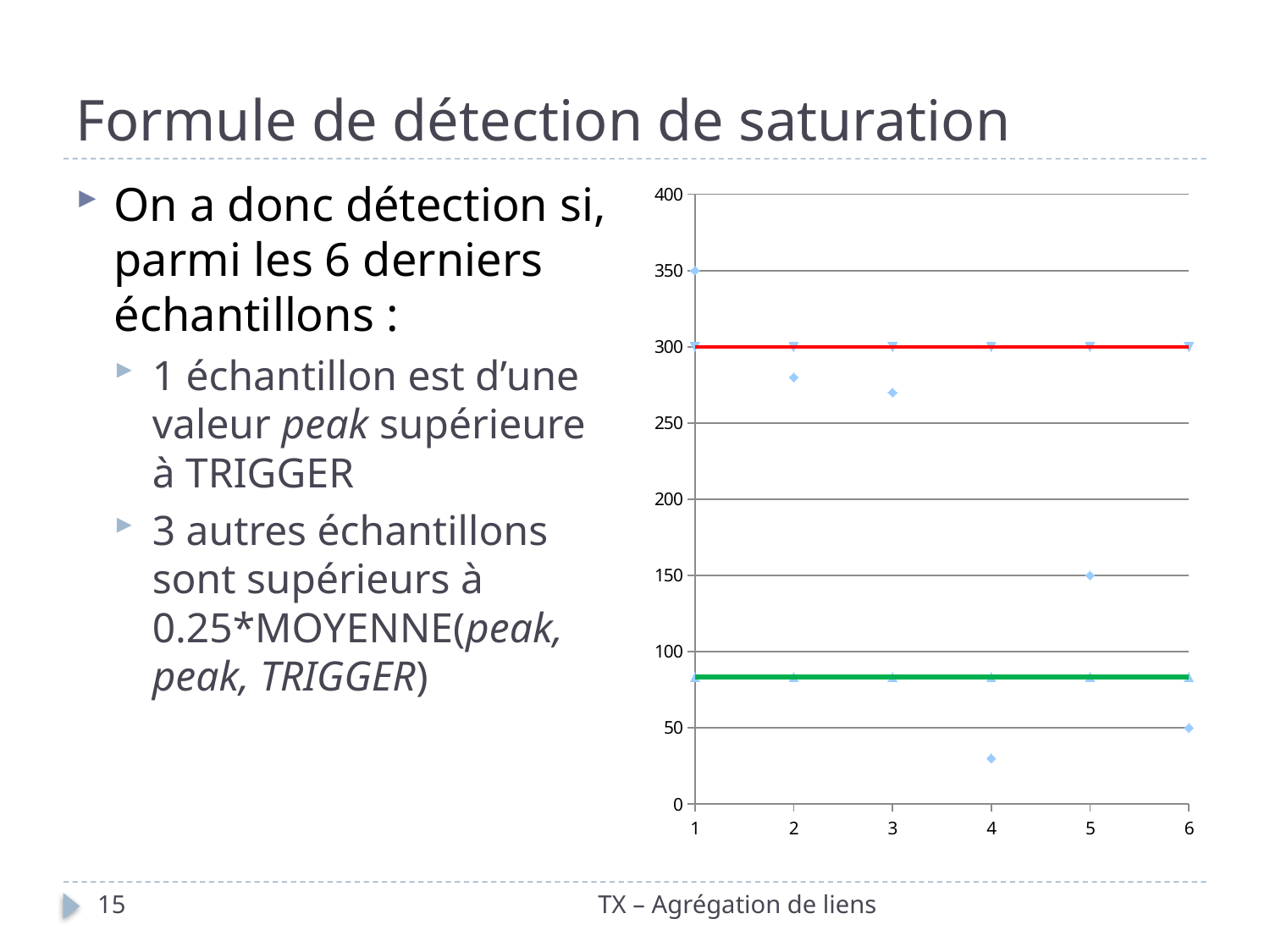
Is the green horizontal line above or below 100? below What kind of chart is shown on the slide? scatter chart What is the value of the blue diamond point at x = 6? 50 Is the blue diamond point at x = 4 greater or less than 50? less Which is larger, the blue diamond point at x = 3 or the blue diamond point at x = 5? x = 3 At which x value is the highest blue diamond point? 1 Is the blue diamond point at x = 2 greater or less than 300? less At which x value is the lowest blue diamond point? 4 What is the value of the blue diamond point at x = 1? 350 How many x-axis positions (samples) are plotted on the chart? 6 At what value does the red horizontal line sit? 300 What is the value of the blue diamond point at x = 5? 150